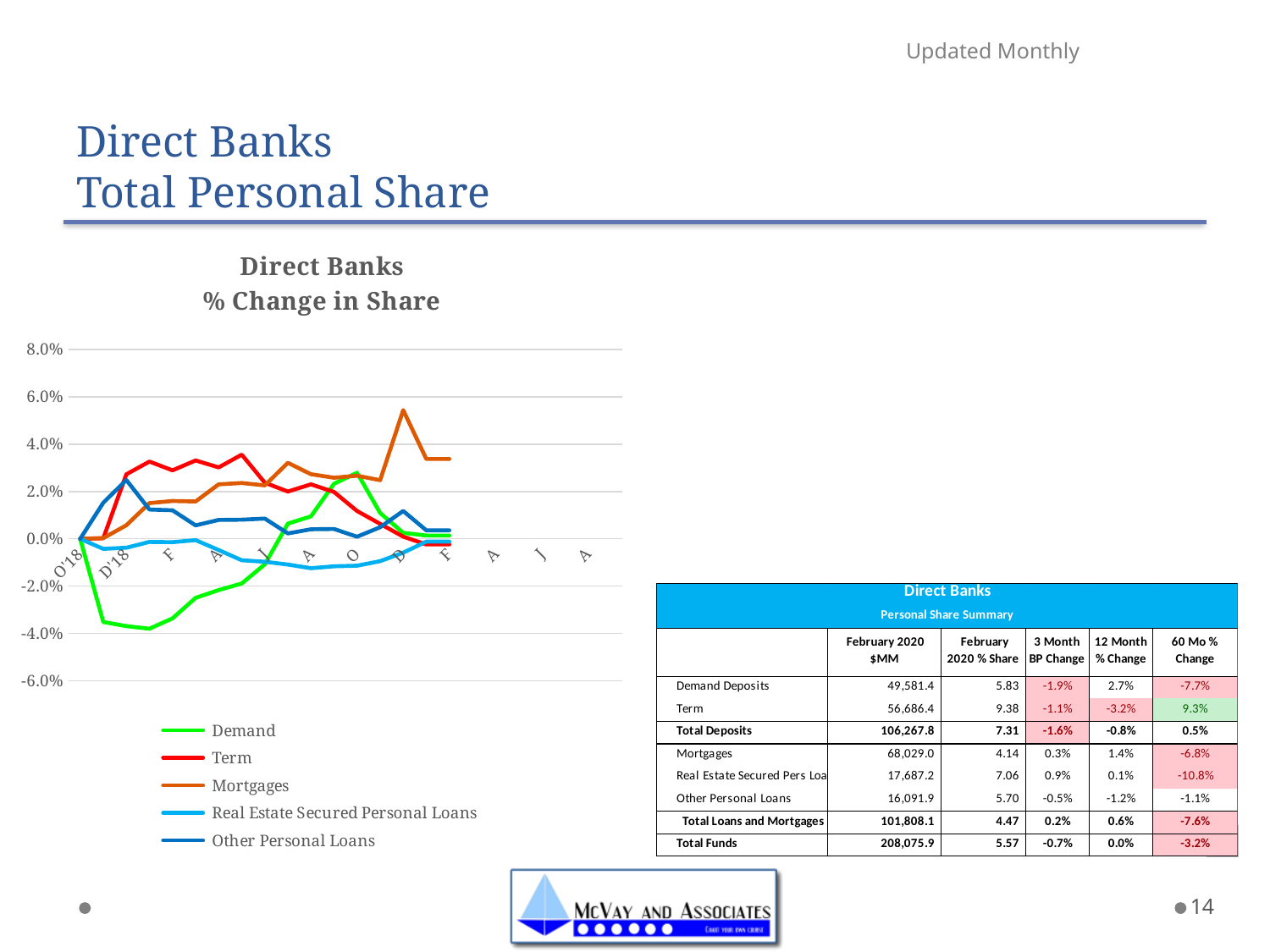
Is the lowest value of the Demand series greater or less than -2.0%? less Does the Term series rise or fall from its mid-2019 peak to the final point in February? fall Does the Demand series rise or fall between D'18 and its peak in late 2019? rise Which colour is used for the Demand series in the chart? green What is the title of the chart? Direct Banks % Change in Share Is the peak value of the Mortgages series greater or less than 4.0%? greater Which series reaches the highest value anywhere on the chart? Mortgages How many series does the chart legend list? 5 Is the highest value of the Term series greater or less than 2.0%? greater Which series reaches the lowest value anywhere on the chart? Demand What kind of chart is shown on the slide? line chart What is the lowest value shown on the vertical axis of the chart? -6.0%